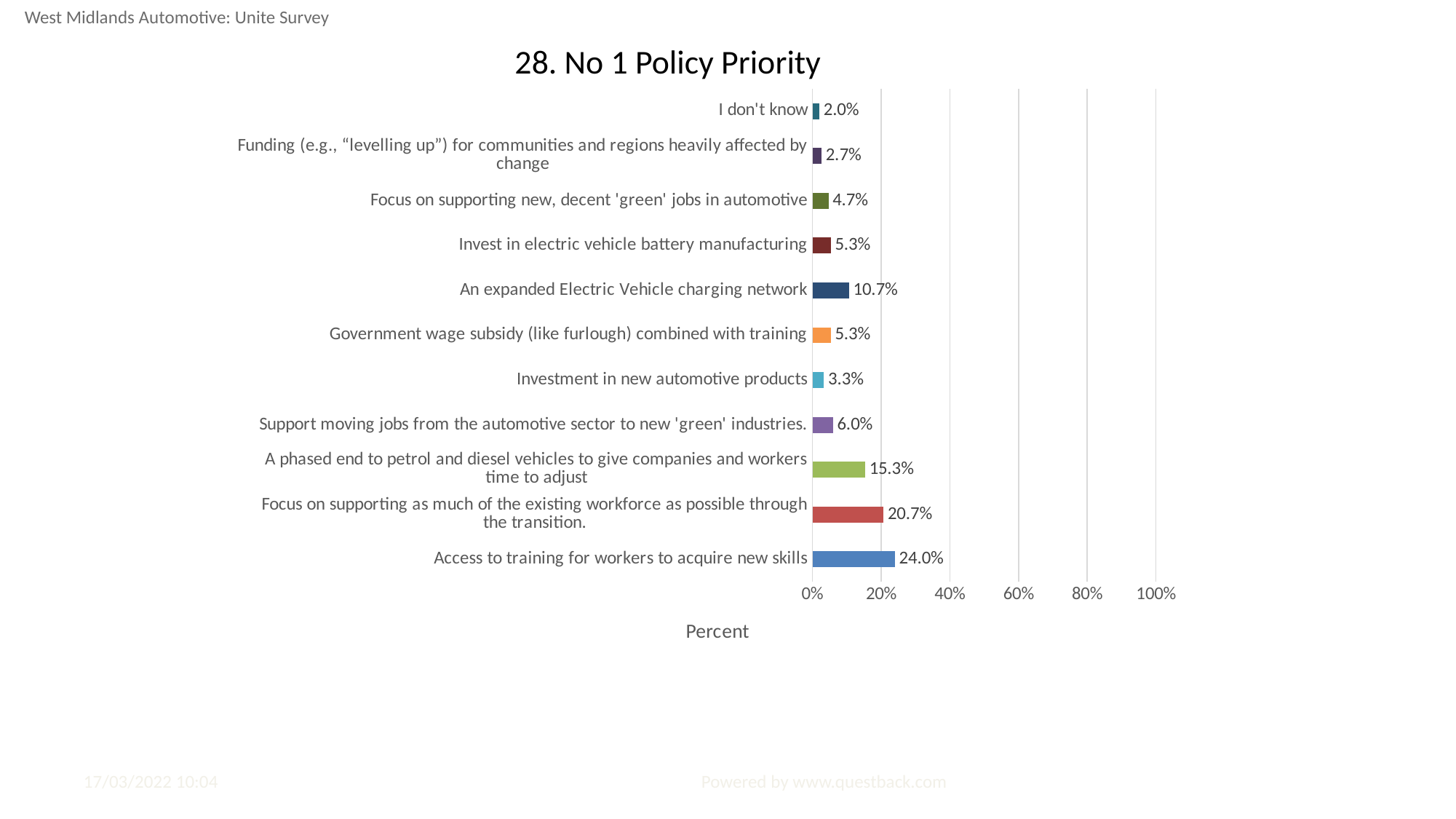
What is the difference between "Access to training for workers to acquire new skills" and "Focus on supporting as much of the existing workforce as possible through the transition."? 3.3% What is the value for "Access to training for workers to acquire new skills"? 24.0% How many categories are shown in the chart? 11 Which category has the lowest value? I don't know Is the value for "Focus on supporting as much of the existing workforce as possible through the transition." greater or less than 40%? less What is the title of the chart? 28. No 1 Policy Priority Which is larger: "Support moving jobs from the automotive sector to new 'green' industries." or "Investment in new automotive products"? Support moving jobs from the automotive sector to new 'green' industries. What is the value for "An expanded Electric Vehicle charging network"? 10.7% Which category has the highest value? Access to training for workers to acquire new skills What is the value for "I don't know"? 2.0% What kind of chart is shown on the slide? bar chart What is the value for "A phased end to petrol and diesel vehicles to give companies and workers time to adjust"? 15.3%